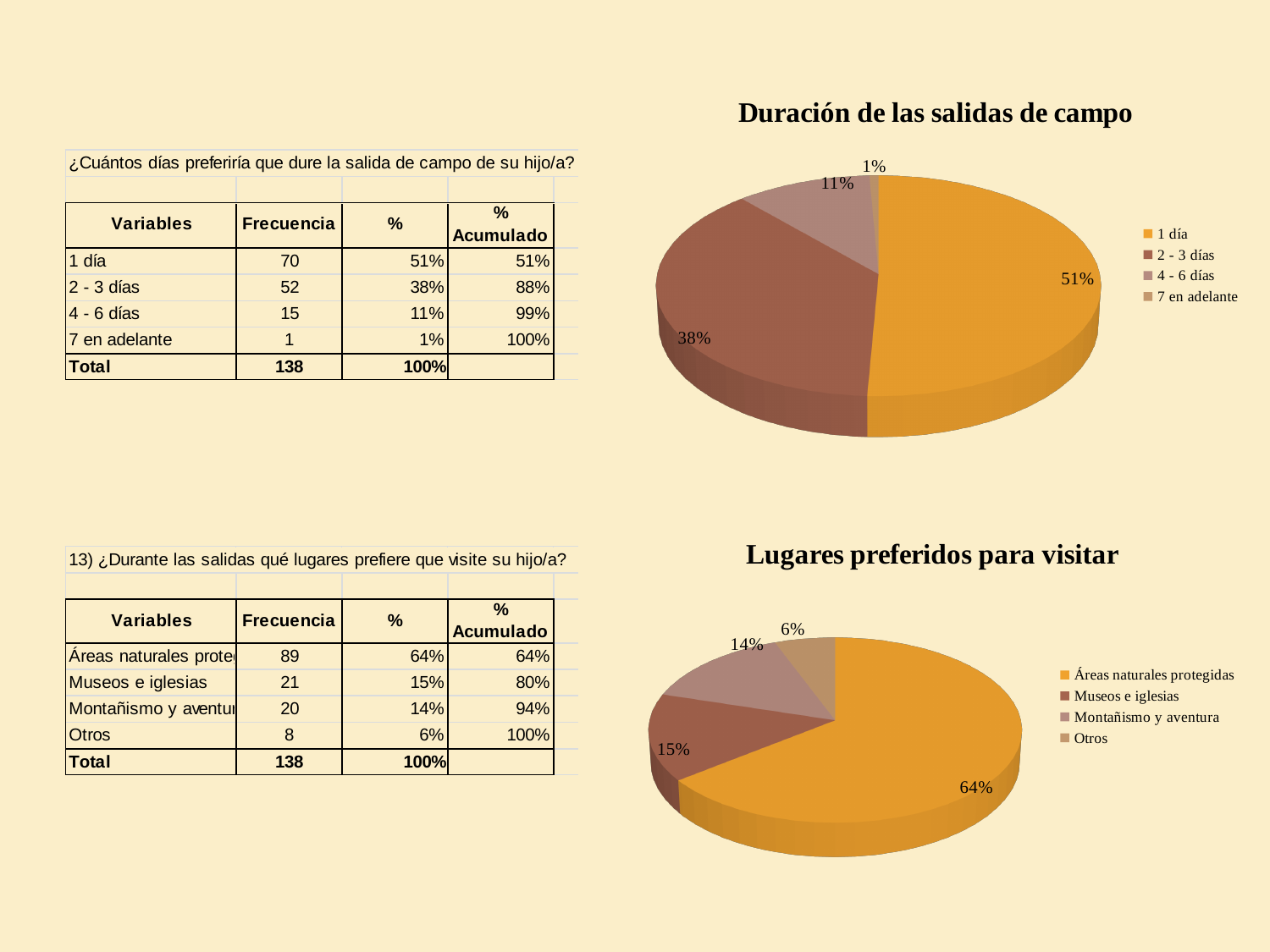
In the 'Lugares preferidos para visitar' chart, what is the value for 'Áreas naturales protegidas'? 64% In the 'Duración de las salidas de campo' chart, which category has the smallest slice? 7 en adelante In the 'Duración de las salidas de campo' chart, how many categories does the legend list? 4 What kind of chart is 'Duración de las salidas de campo'? Pie chart In the 'Lugares preferidos para visitar' chart, what is the difference between 'Museos e iglesias' and 'Montañismo y aventura'? 1% What is the title of the pie chart at the bottom of the slide? Lugares preferidos para visitar In the 'Lugares preferidos para visitar' chart, what is the value for 'Otros'? 6% In the 'Duración de las salidas de campo' chart, what share of the pie does '1 día' have? 51% In the 'Duración de las salidas de campo' chart, what is the value for '2 - 3 días'? 38% In the 'Lugares preferidos para visitar' chart, which is larger, 'Museos e iglesias' or 'Otros'? Museos e iglesias In the 'Duración de las salidas de campo' chart, what is the difference between the '1 día' and '4 - 6 días' shares? 40% In the 'Lugares preferidos para visitar' chart, which category has the largest slice? Áreas naturales protegidas